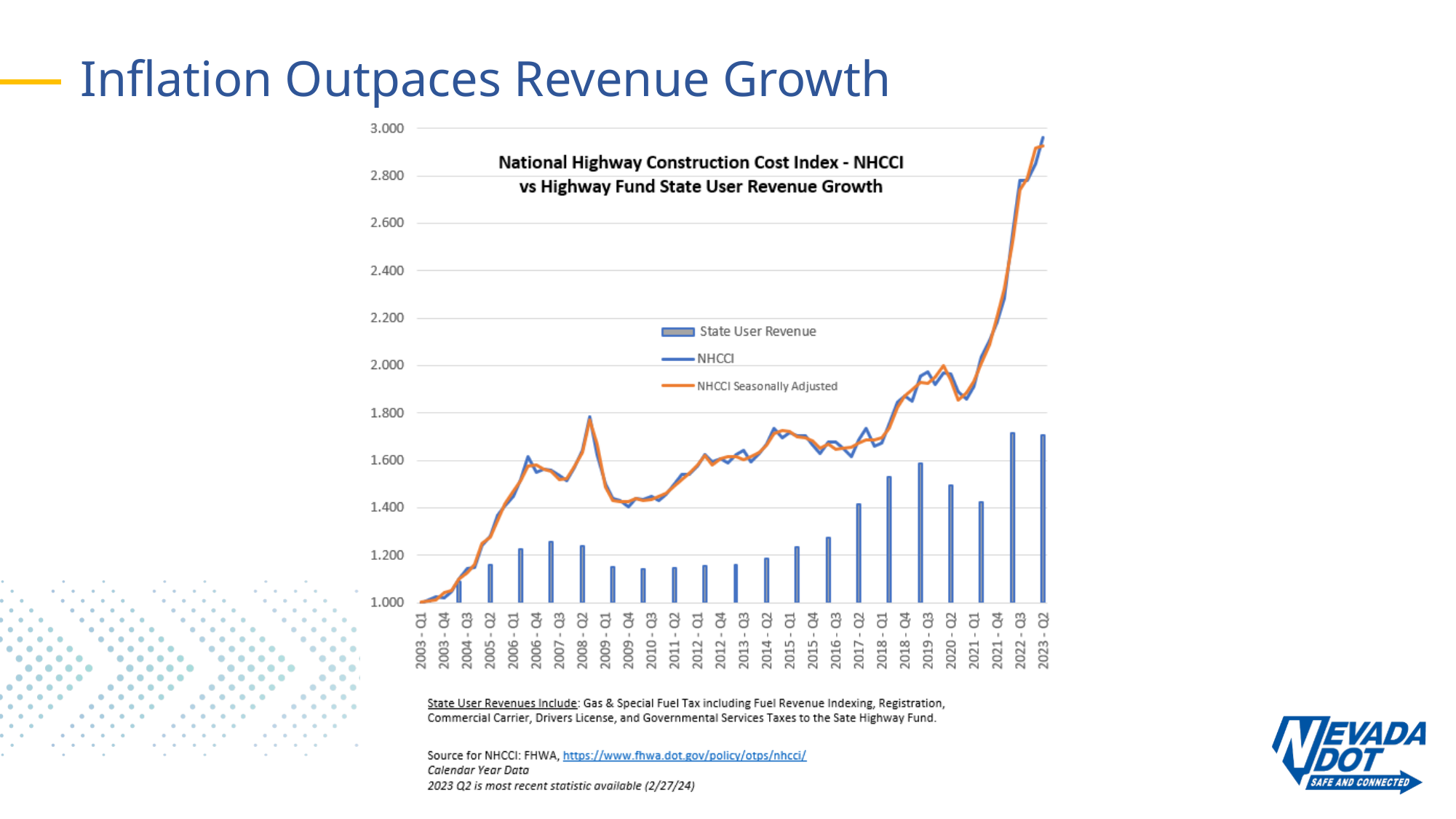
Is the State User Revenue value at 2010 - Q3 greater or less than 1.200? less Is the State User Revenue value at 2022 - Q3 greater or less than 1.600? greater Which is larger, the State User Revenue bar for 2019 - Q3 or for 2020 - Q2? 2019 - Q3 What is the NHCCI value at 2003 - Q1? 1.000 Is the NHCCI value at 2008 - Q2 greater or less than 1.600? greater At which quarter is the State User Revenue bar lowest? 2004 - Q3 What is the title of the chart? National Highway Construction Cost Index - NHCCI vs Highway Fund State User Revenue Growth What kind of chart is shown on the slide? Combination bar and line chart How many series does the chart legend list? 3 Overall, does the NHCCI line rise or fall from 2003 to 2023? rise Which series is drawn in orange? NHCCI Seasonally Adjusted